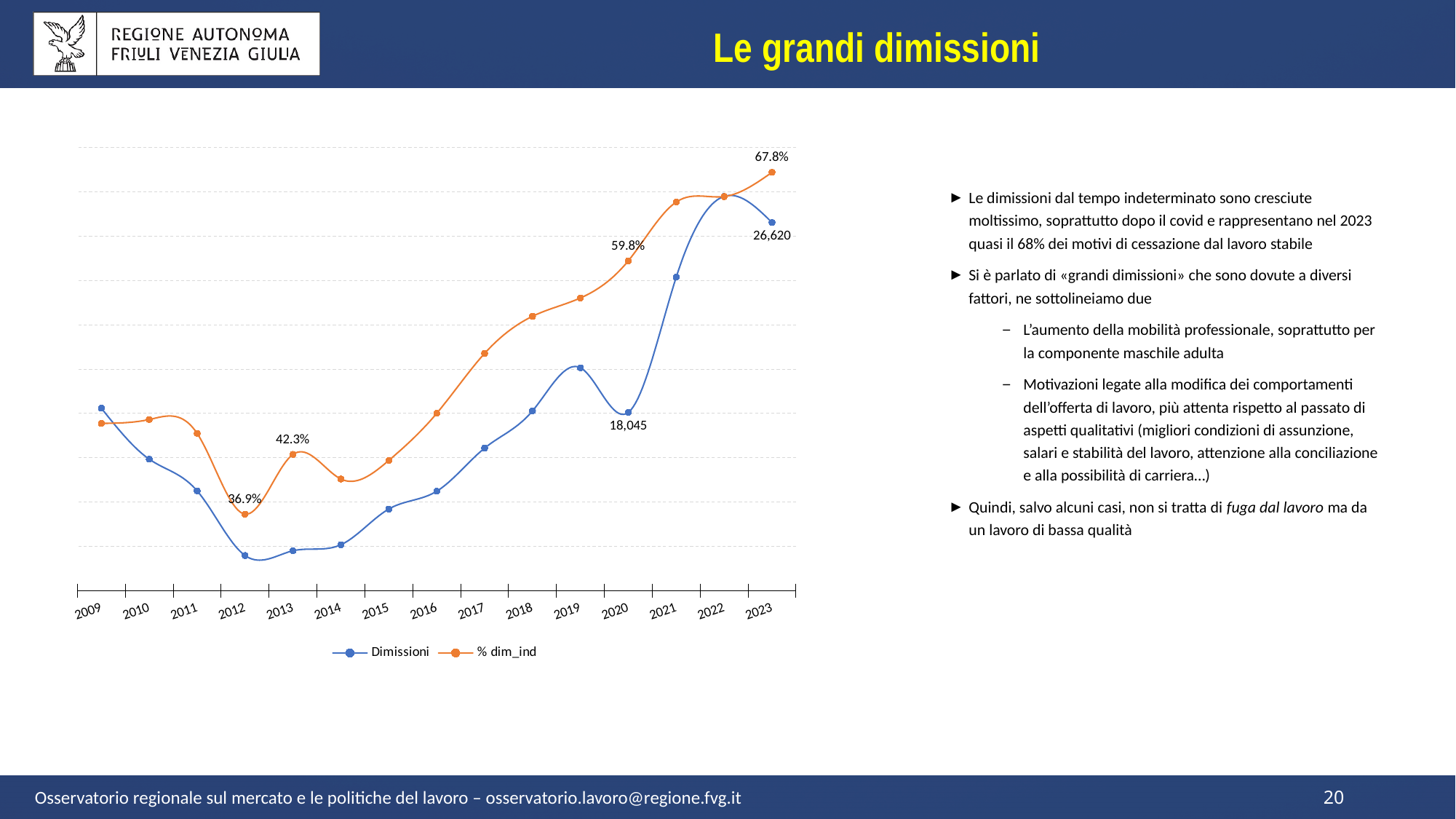
What is the value of % dim_ind in 2012? 36.9% In which year does the Dimissioni series reach its highest point? 2022 How many years are plotted along the x axis of the chart? 15 In which year is the % dim_ind series at its lowest? 2012 What is the value of Dimissioni in 2020? 18,045 What type of chart is shown on the slide? line chart What is the value of % dim_ind in 2023? 67.8% Which series are listed in the chart legend? Dimissioni and % dim_ind What is the value of Dimissioni in 2023? 26,620 By how much did Dimissioni increase from 2020 to 2023? 8,575 How many series does the chart legend list? 2 What is the value of % dim_ind in 2013? 42.3%